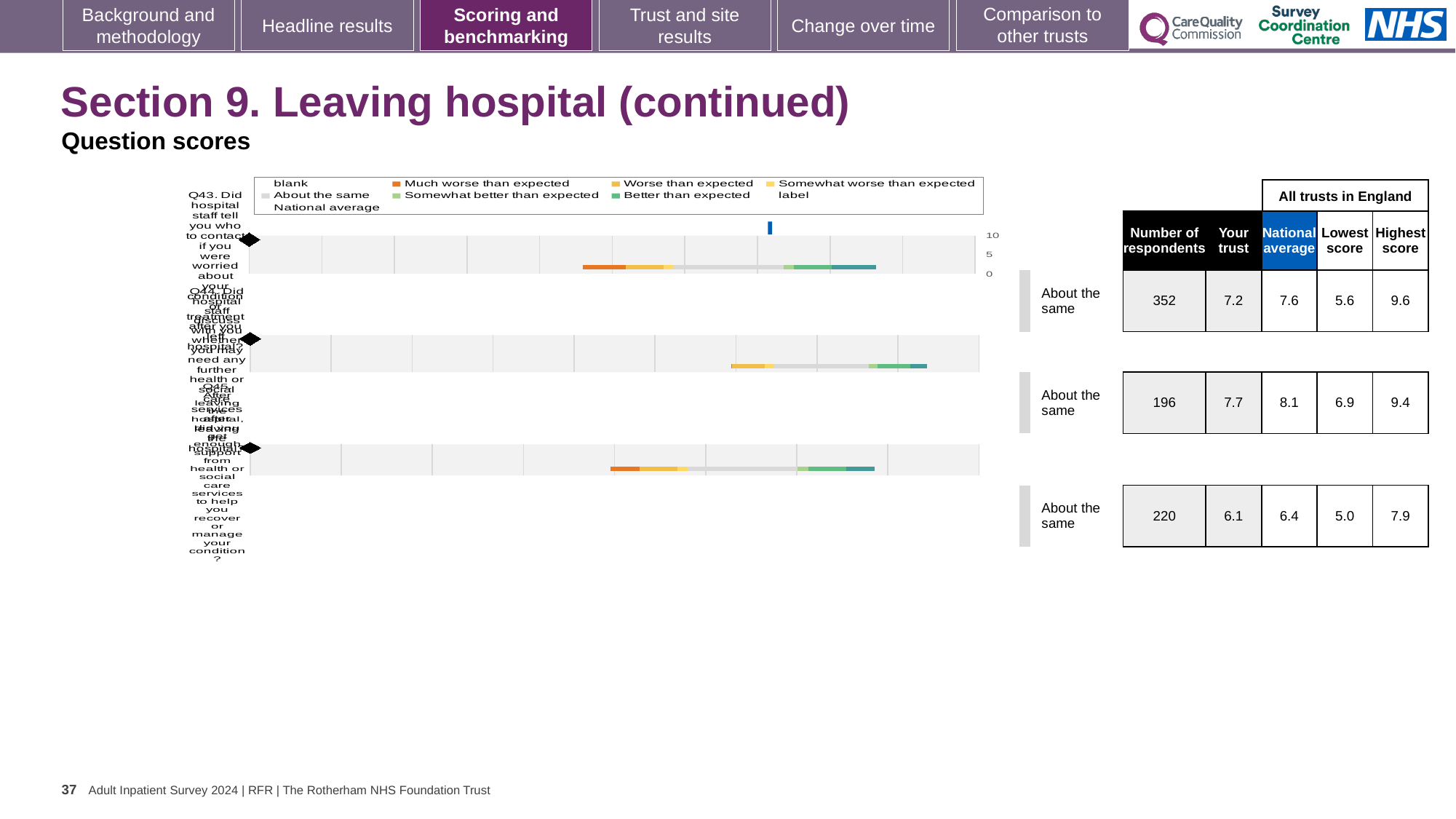
Which question row has the highest 'Your trust' score? the second row (7.7) For the first question (Q43), what is the difference between the highest score and the lowest score across all trusts in England? 4.0 What kind of chart is shown on the slide? bar chart How many questions (bars) are plotted in the chart? 3 What benchmark category is shown next to each of the three questions? About the same What is the highest score among all trusts in England for the third question row? 7.9 For the first question (Q43), which is larger: the 'Your trust' score or the national average? the national average For the third question row, what is the difference between the national average and the 'Your trust' score? 0.3 What is the 'Your trust' score for the first question (Q43)? 7.2 What is the national average for the second question in the table? 8.1 What is the number of respondents for the first question (Q43)? 352 Which question row has the lowest 'Your trust' score? the third row (6.1)